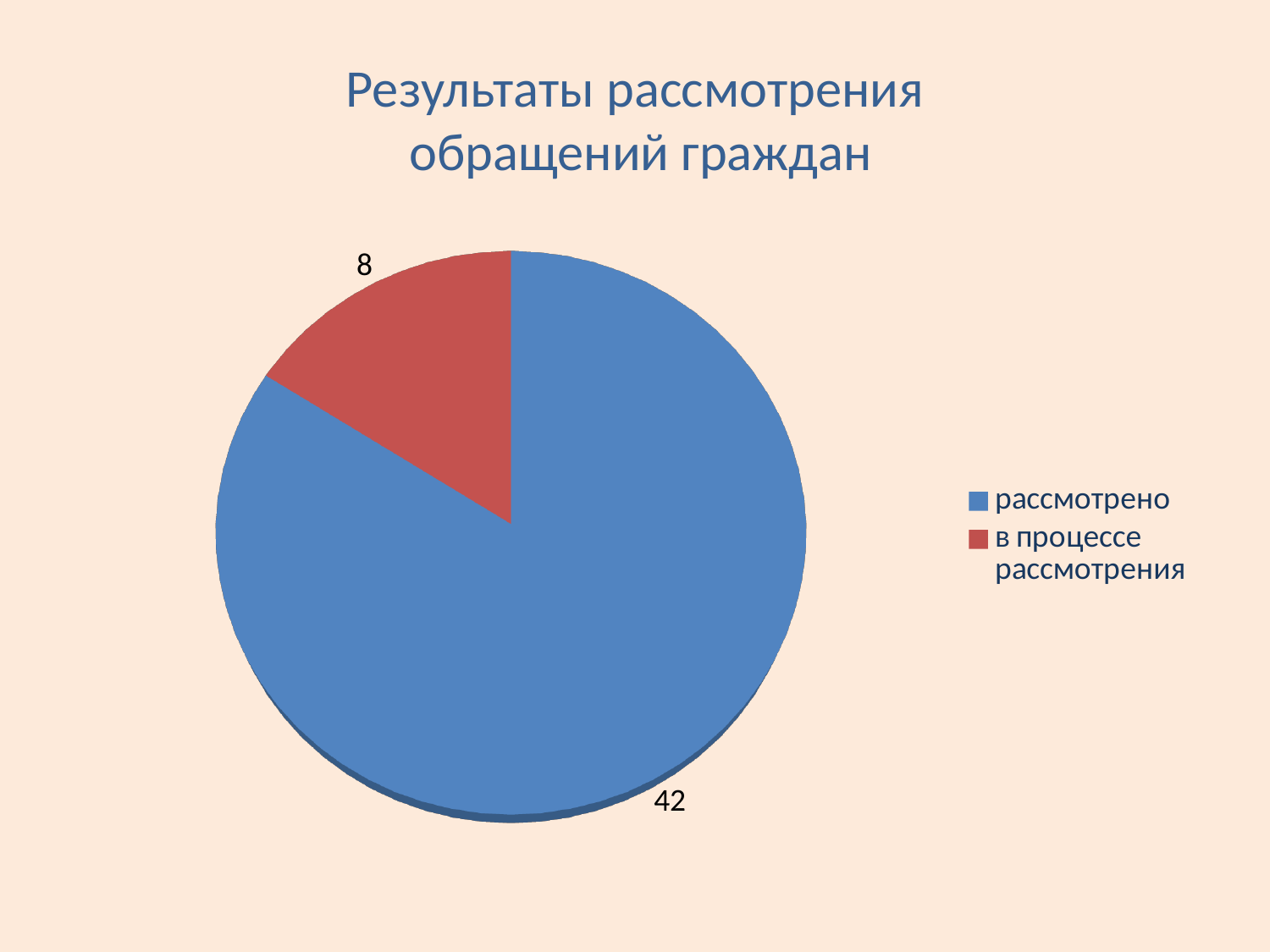
What type of chart is shown on the slide? pie chart How many slices does the pie chart have? 2 Which is larger: "рассмотрено" or "в процессе рассмотрения"? рассмотрено What is the difference between the values for "рассмотрено" and "в процессе рассмотрения"? 34 What is the value for "в процессе рассмотрения"? 8 What is the value for "рассмотрено"? 42 What share of the pie does "в процессе рассмотрения" represent? 16% What is the title of the chart? Результаты рассмотрения обращений граждан How many entries does the legend list? 2 What is the total of all slices in the pie chart? 50 Which category has the smallest slice? в процессе рассмотрения Which category has the largest slice? рассмотрено